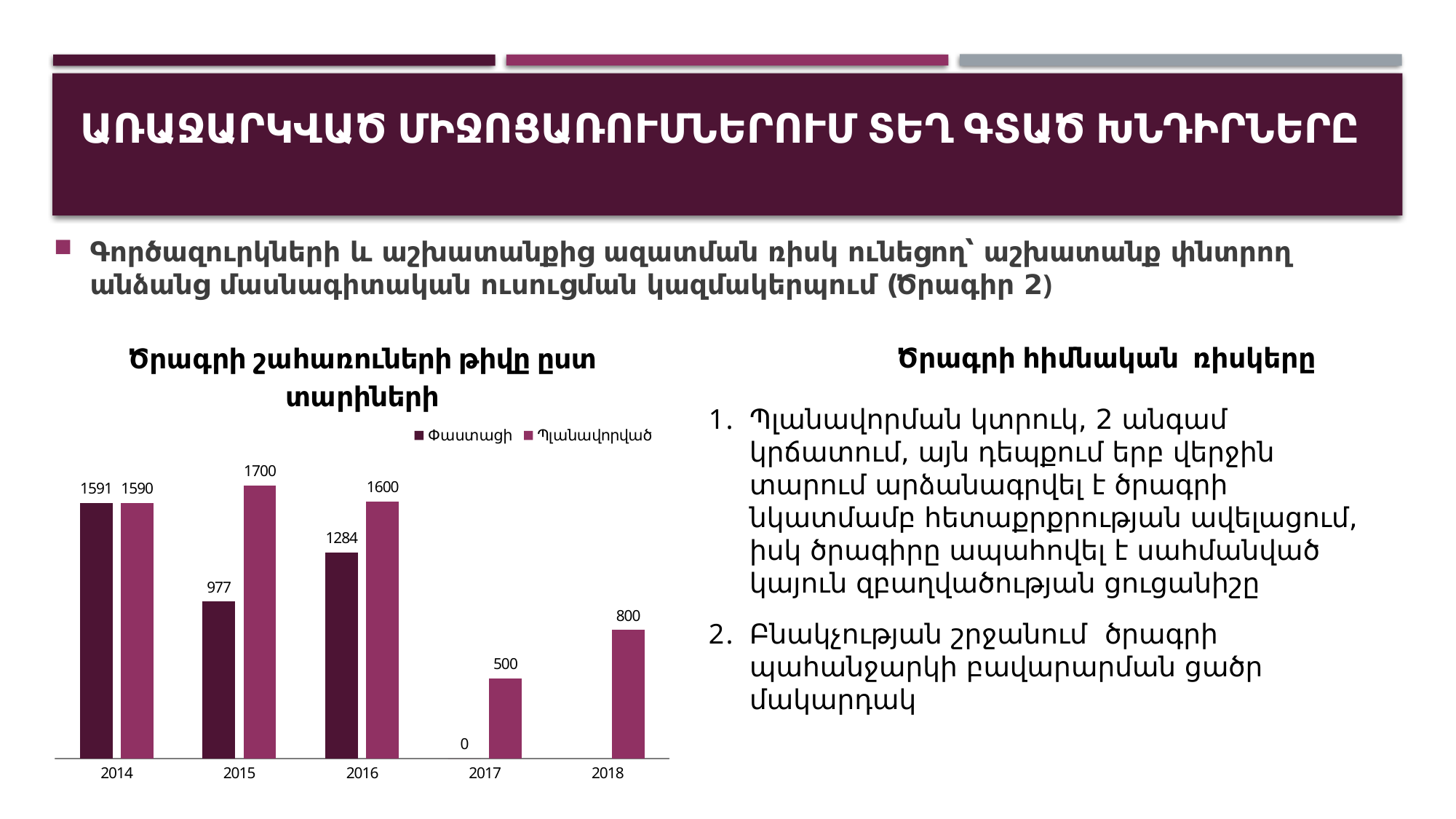
How many series does the chart legend list? 2 Which is larger in 2014, the Փաստացի value or the Պլանավորված value? Փաստացի What is the difference between the Պլանավորված and Փաստացի values for 2015? 723 What is the Փաստացի value for 2015? 977 How many years are shown on the x axis of the chart? 5 What is the Պլանավորված value for 2018? 800 What type of chart is shown on the slide? Bar chart Which year has the highest Պլանավորված value? 2015 What is the Փաստացի value for 2017? 0 What is the difference between the Պլանավորված and Փաստացի values for 2016? 316 What is the Պլանավորված value for 2016? 1600 Which year has the lowest Պլանավորված value? 2017